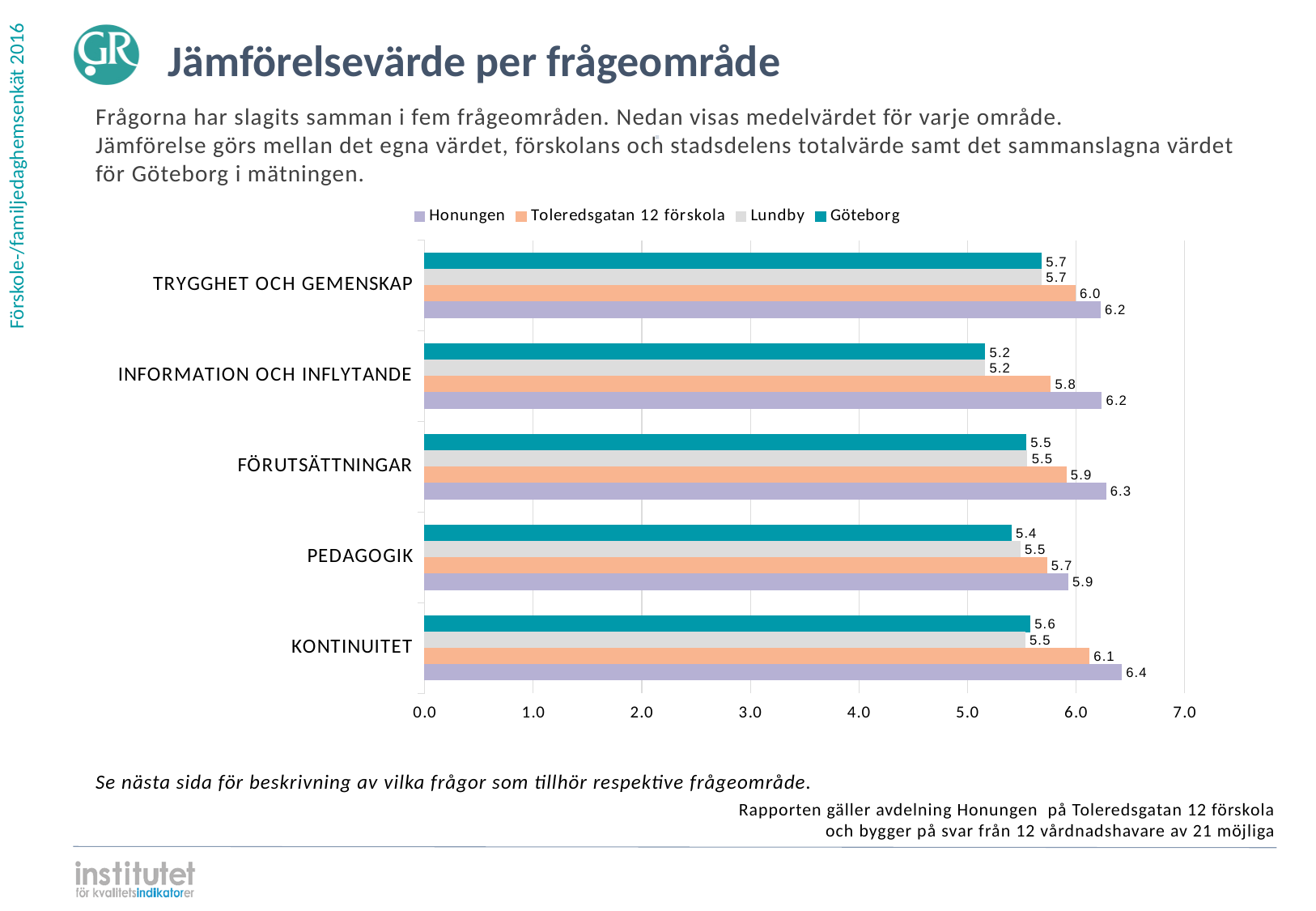
In which category does Honungen have its highest value? KONTINUITET What is the value for Toleredsgatan 12 förskola in the PEDAGOGIK category? 5.7 What kind of chart is shown on the slide? Bar chart In which category does Göteborg have its lowest value? INFORMATION OCH INFLYTANDE Which series is shown in teal on the chart? Göteborg What is the difference between the Honungen and Göteborg values in the INFORMATION OCH INFLYTANDE category? 1.0 What is the value for Göteborg in the INFORMATION OCH INFLYTANDE category? 5.2 How many categories are shown on the chart? 5 What is the value for Lundby in the FÖRUTSÄTTNINGAR category? 5.5 How many series does the legend list? 4 What is the value for Honungen in the KONTINUITET category? 6.4 Which is larger in the PEDAGOGIK category: the value for Honungen or the value for Toleredsgatan 12 förskola? Honungen